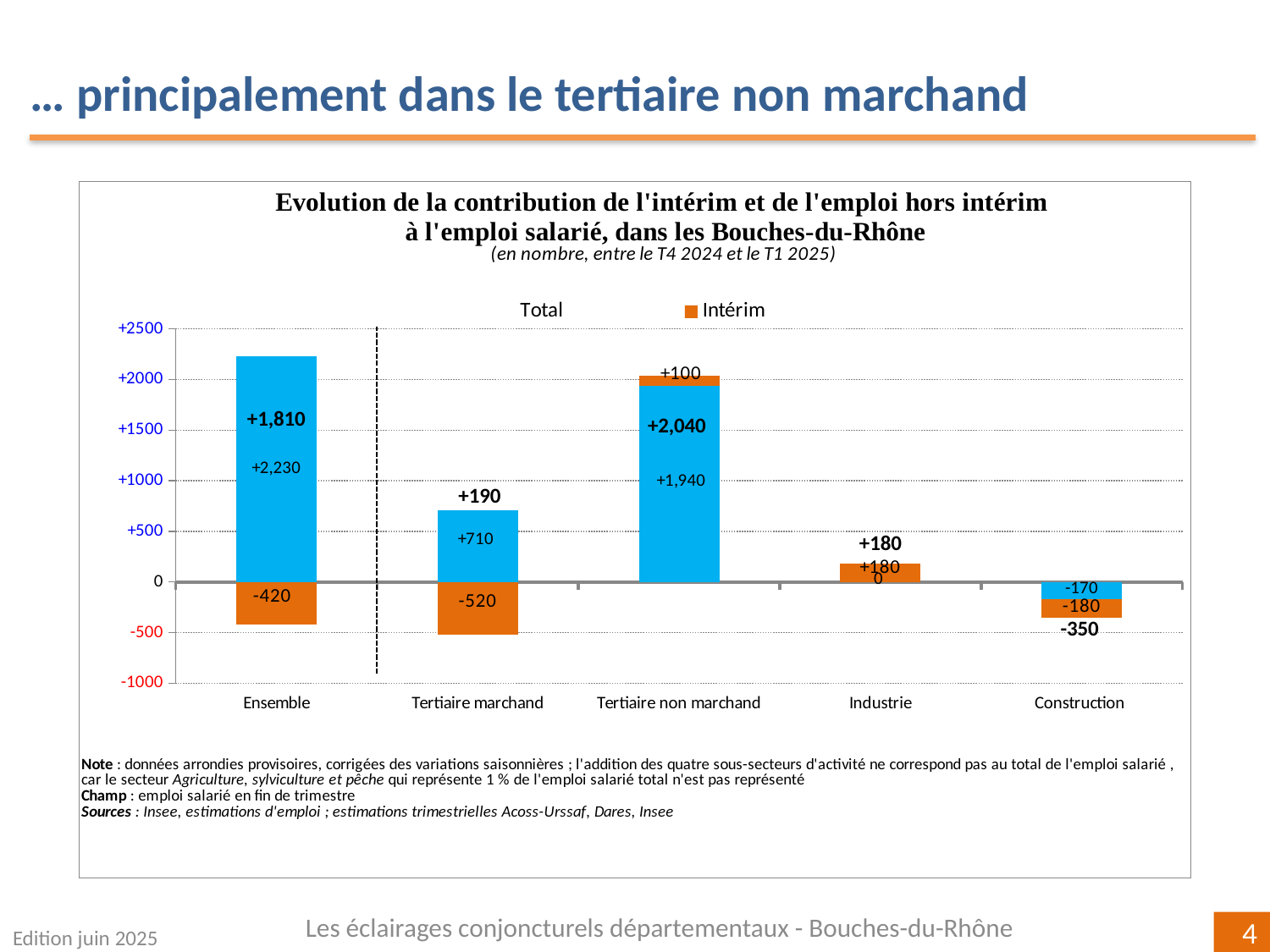
What is the difference between the total values for Tertiaire non marchand (+2,040) and Ensemble (+1,810)? 230 Which is larger, the total value for Tertiaire marchand or the total value for Industrie? Tertiaire marchand What is the blue (non-Intérim) value shown for Tertiaire non marchand? +1,940 What is the total value shown for Tertiaire non marchand? +2,040 Which category has the highest total value? Tertiaire non marchand What is the total value shown for Construction? -350 What kind of chart is shown on the slide? Bar chart How many entries does the legend list? 2 What is the Intérim value shown for Tertiaire marchand? -520 How many categories are shown on the x axis? 5 What is the Intérim value shown for Ensemble? -420 Which category has the lowest total value? Construction